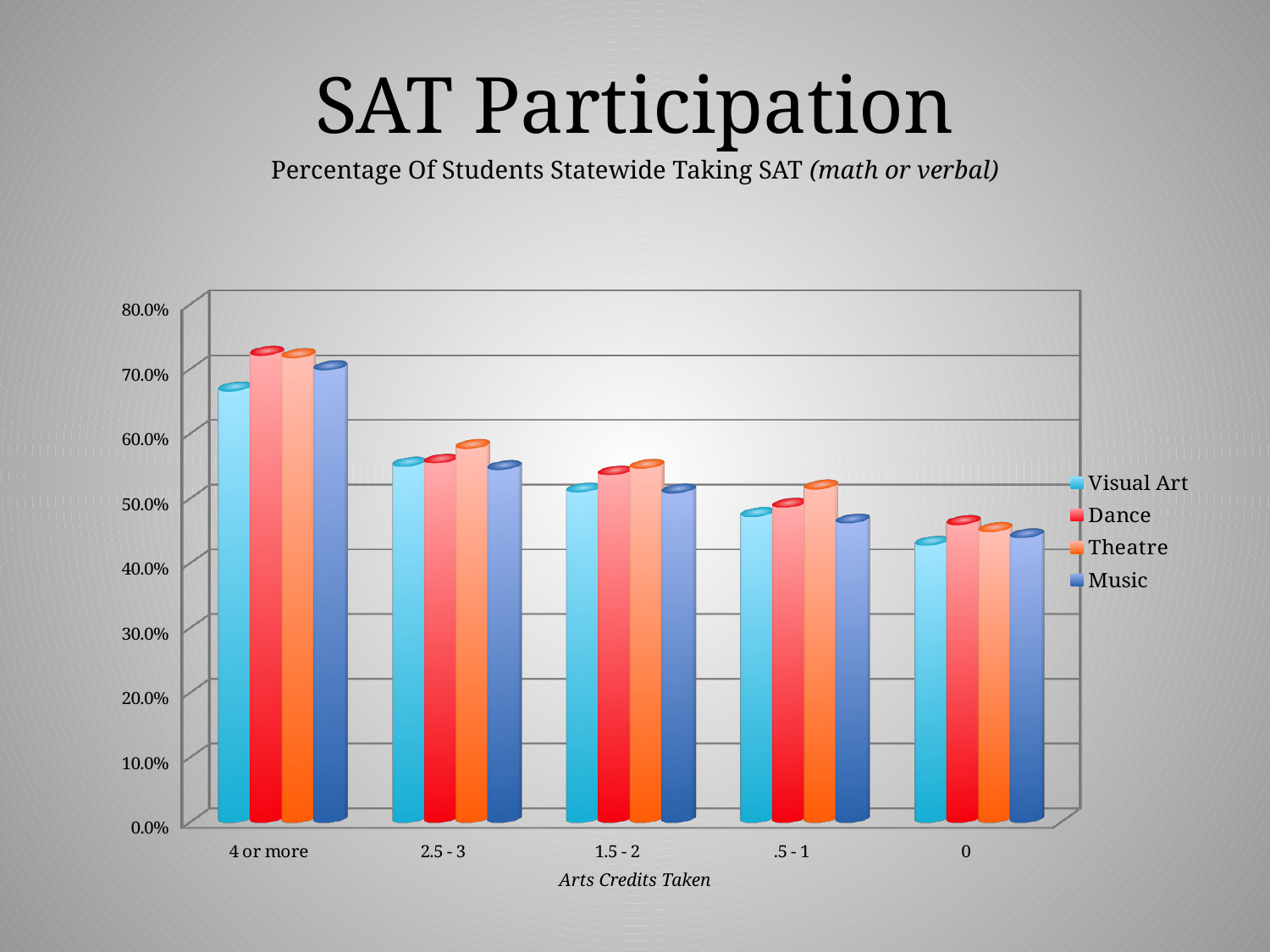
How many series does the legend list? 4 Is the Dance value for '4 or more' greater or less than 70.0%? greater For '4 or more' credits, which is larger: the Dance value or the Visual Art value? Dance What kind of chart is shown on the slide? Bar chart Which arts credits category has the highest Visual Art value? 4 or more How many categories of arts credits are shown on the x axis? 5 Is the Visual Art value for '4 or more' greater or less than 70.0%? less Do the SAT participation values rise or fall moving from '4 or more' to '0' along the x axis? Fall Which arts credits category has the lowest Music value? 0 What is the title of the x axis? Arts Credits Taken Is the Music value for '1.5 - 2' greater or less than 60.0%? less